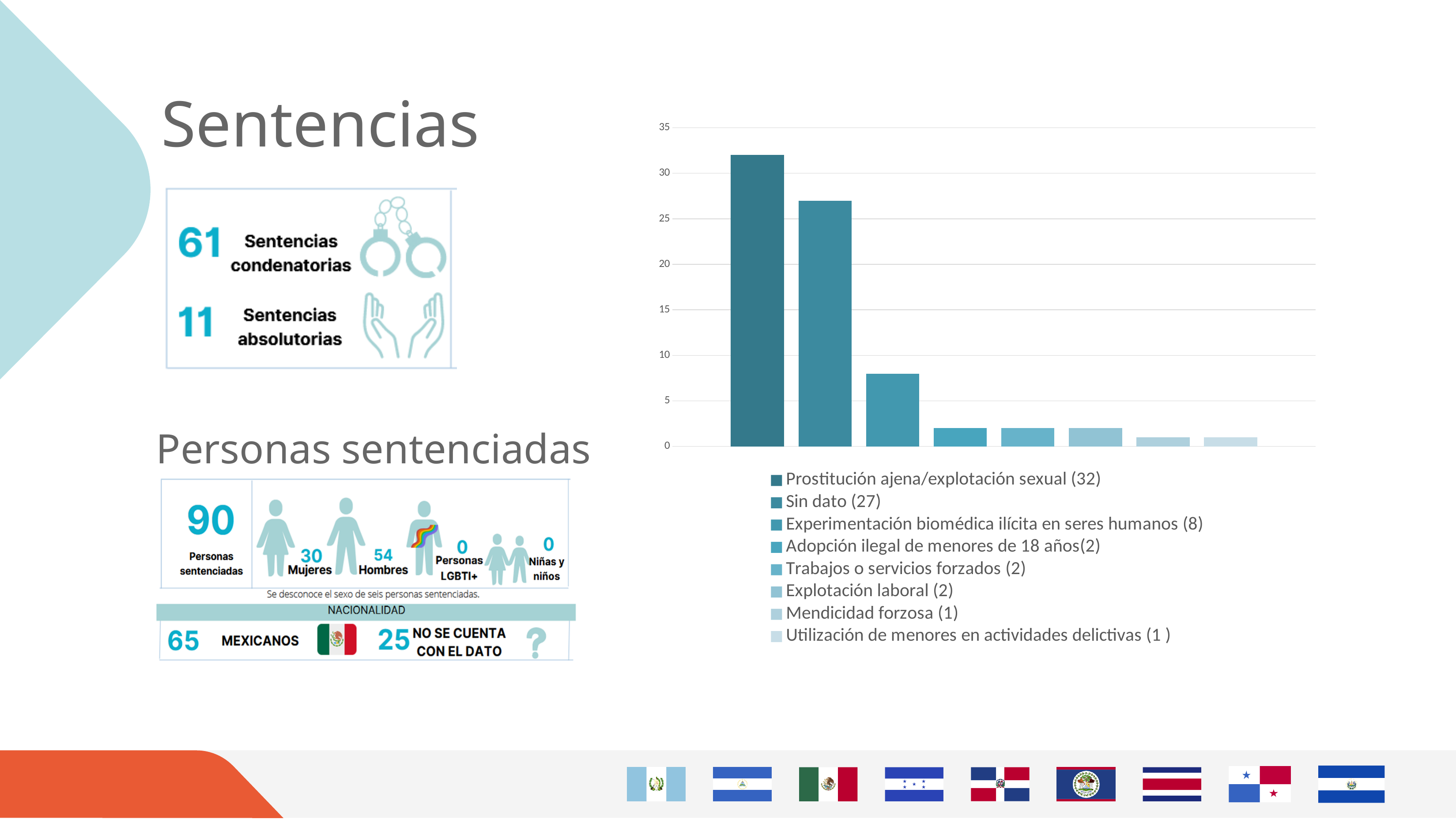
How many entries does the legend of the bar chart list? 8 Which category has the highest value in the bar chart? Prostitución ajena/explotación sexual What is the value for Sin dato in the bar chart? 27 How many bars are plotted in the bar chart? 8 What kind of chart is shown on the right of the slide? bar chart What is the value for Prostitución ajena/explotación sexual in the bar chart? 32 What is the difference between the values for Prostitución ajena/explotación sexual and Sin dato? 5 What is the value for Mendicidad forzosa in the bar chart? 1 Do the bar values rise or fall from left to right in the bar chart? fall Is the value for Prostitución ajena/explotación sexual greater or less than 30? greater What is the value for Experimentación biomédica ilícita en seres humanos in the bar chart? 8 Which is larger in the bar chart: Sin dato or Experimentación biomédica ilícita en seres humanos? Sin dato